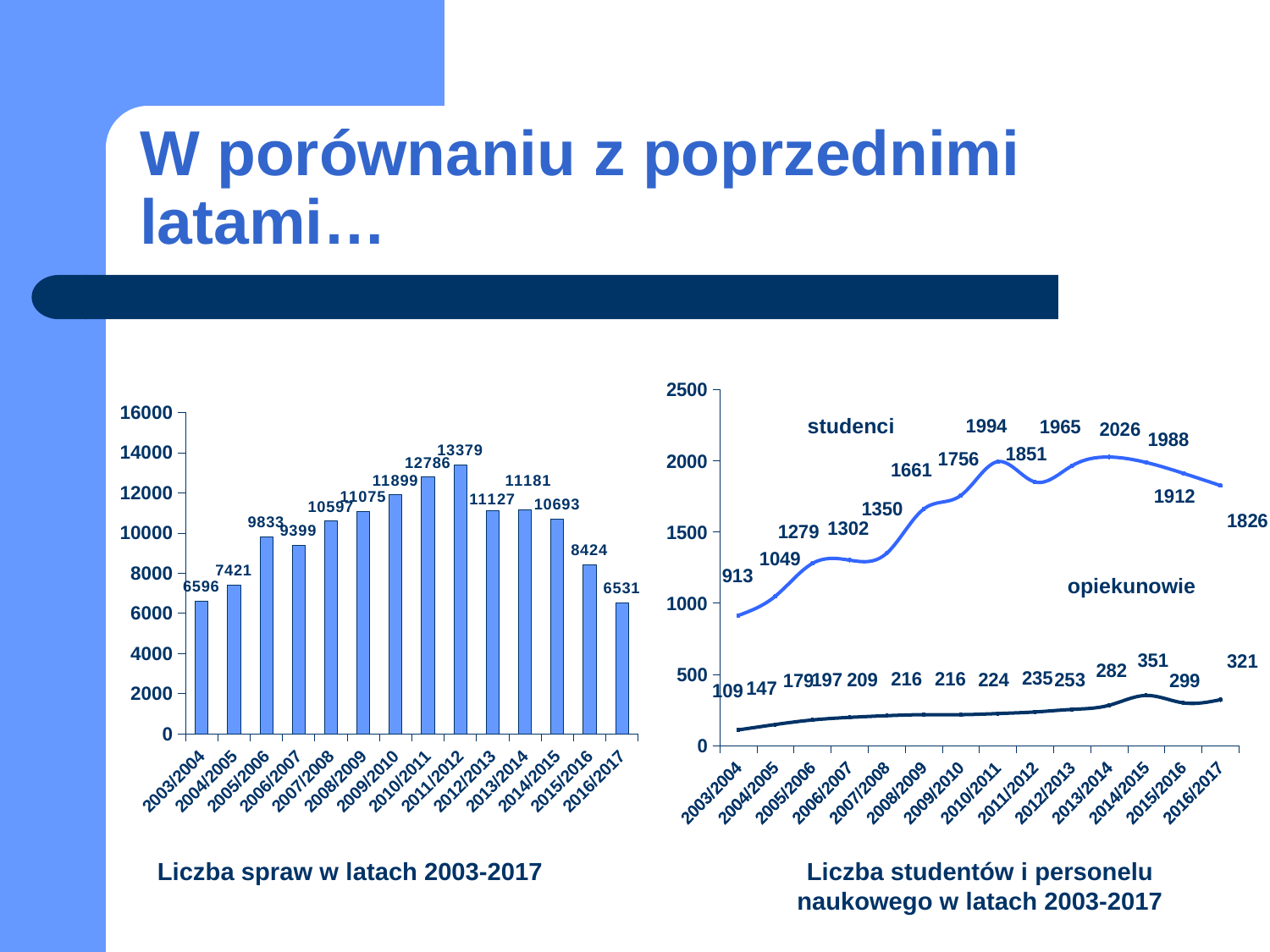
On the chart 'Liczba studentów i personelu naukowego w latach 2003-2017', what is the value for opiekunowie in 2014/2015? 351 On the chart 'Liczba studentów i personelu naukowego w latach 2003-2017', which series has the higher value in 2016/2017, studenci or opiekunowie? studenci On the chart 'Liczba spraw w latach 2003-2017', which year has the highest value? 2011/2012 On the chart 'Liczba spraw w latach 2003-2017', which year has the lowest value? 2016/2017 On the chart 'Liczba studentów i personelu naukowego w latach 2003-2017', what is the difference between the studenci values for 2003/2004 and 2016/2017? 913 On the chart 'Liczba spraw w latach 2003-2017', how many years are shown on the x axis? 14 What kind of chart is 'Liczba spraw w latach 2003-2017'? bar chart What kind of chart is 'Liczba studentów i personelu naukowego w latach 2003-2017'? line chart On the chart 'Liczba spraw w latach 2003-2017', what is the difference between the values for 2015/2016 and 2016/2017? 1893 How many series are plotted on the chart 'Liczba studentów i personelu naukowego w latach 2003-2017'? 2 On the chart 'Liczba spraw w latach 2003-2017', what is the value for 2011/2012? 13379 On the chart 'Liczba studentów i personelu naukowego w latach 2003-2017', what is the value for studenci in 2013/2014? 2026